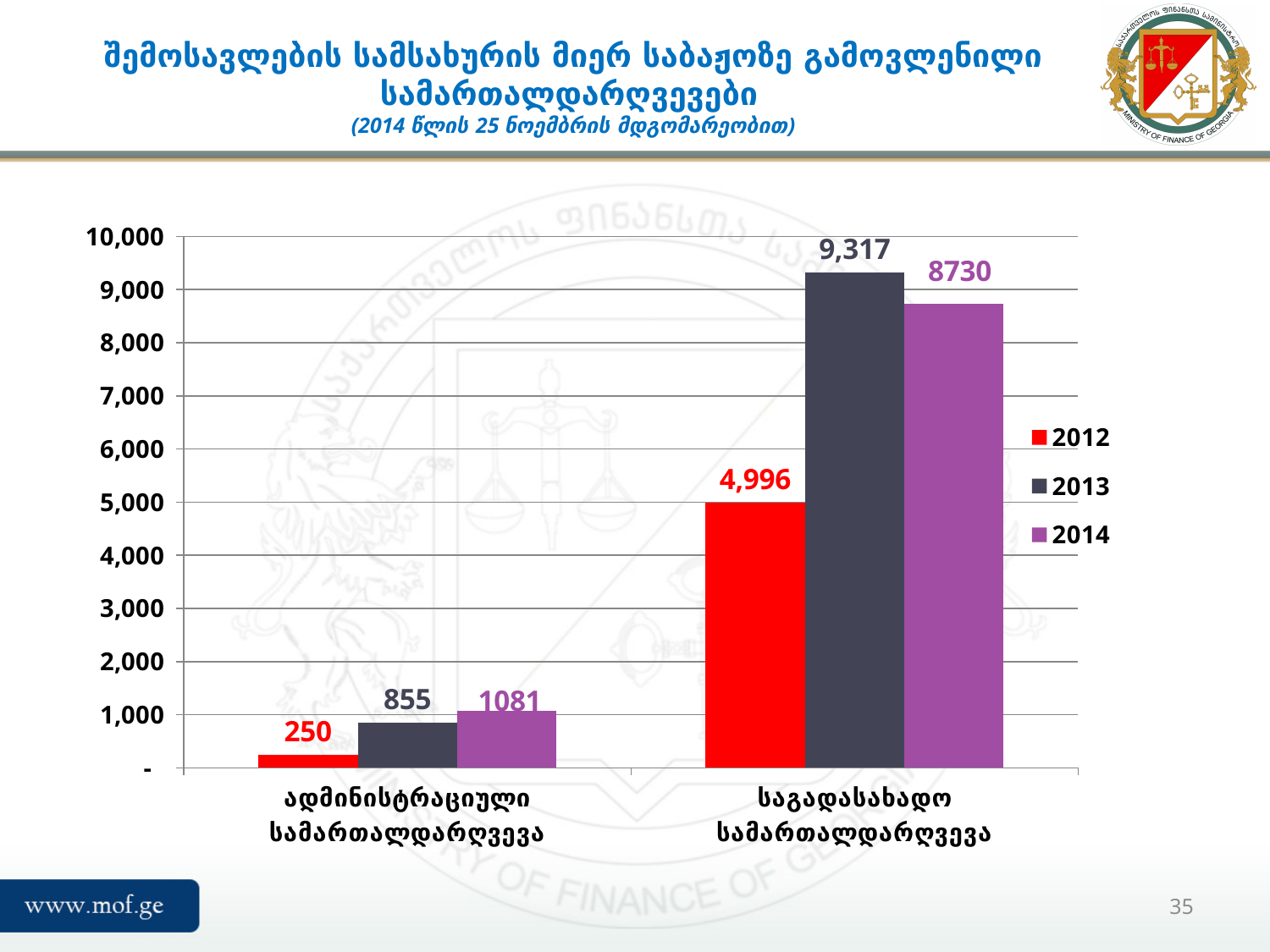
Which is larger: the 2012 value for საგადასახადო სამართალდარღვევა or the 2014 value for ადმინისტრაციული სამართალდარღვევა? 2012 value for საგადასახადო სამართალდარღვევა What is the value for 2013 in the საგადასახადო სამართალდარღვევა category? 9,317 What is the difference between the 2013 and 2014 values in the საგადასახადო სამართალდარღვევა category? 587 What is the value for 2012 in the ადმინისტრაციული სამართალდარღვევა category? 250 How many categories are shown on the x axis? 2 Which year has the lowest value in the ადმინისტრაციული სამართალდარღვევა category? 2012 Which year has the highest value in the საგადასახადო სამართალდარღვევა category? 2013 What is the value for 2014 in the ადმინისტრაციული სამართალდარღვევა category? 1081 How many series does the legend list? 3 What kind of chart is shown on the slide? Bar chart What is the value for 2012 in the საგადასახადო სამართალდარღვევა category? 4,996 What is the difference between the 2014 and 2013 values in the ადმინისტრაციული სამართალდარღვევა category? 226